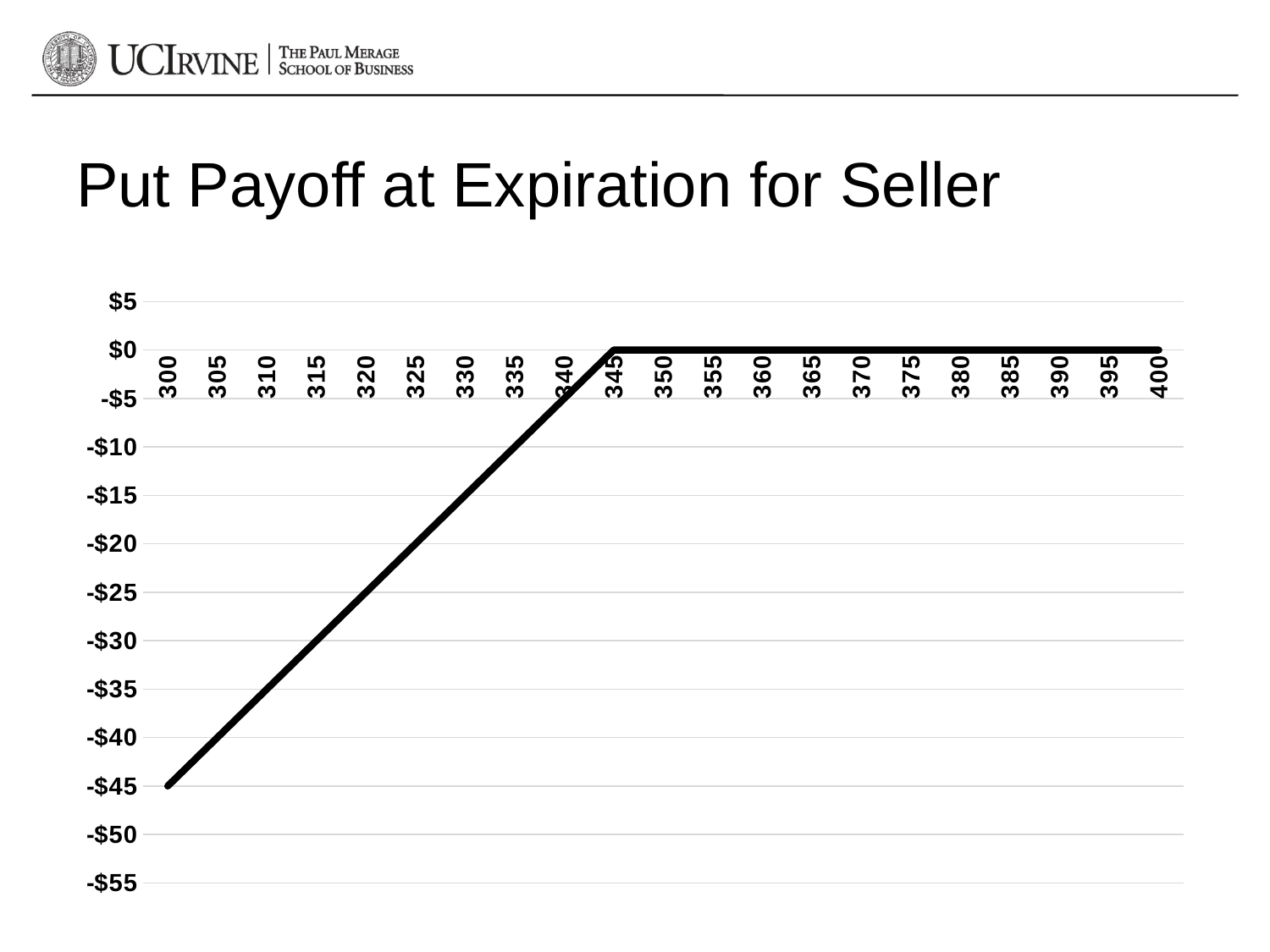
What is the difference between the payoff at 345 and the payoff at 300? $45 Is the payoff at a price of 320 greater or less than -$10? less Does the payoff rise or fall as the price moves from 300 to 345? rise What is the payoff value at a price of 400? $0 What is the title of the chart? Put Payoff at Expiration for Seller Which is larger, the payoff at 310 or the payoff at 330? 330 What kind of chart is shown on the slide? line chart At which x-axis price is the payoff lowest? 300 What is the payoff value at a price of 345? $0 How many points are labelled along the x axis? 21 Is the payoff at a price of 340 greater or less than -$20? greater What is the payoff value at a price of 300? -$45